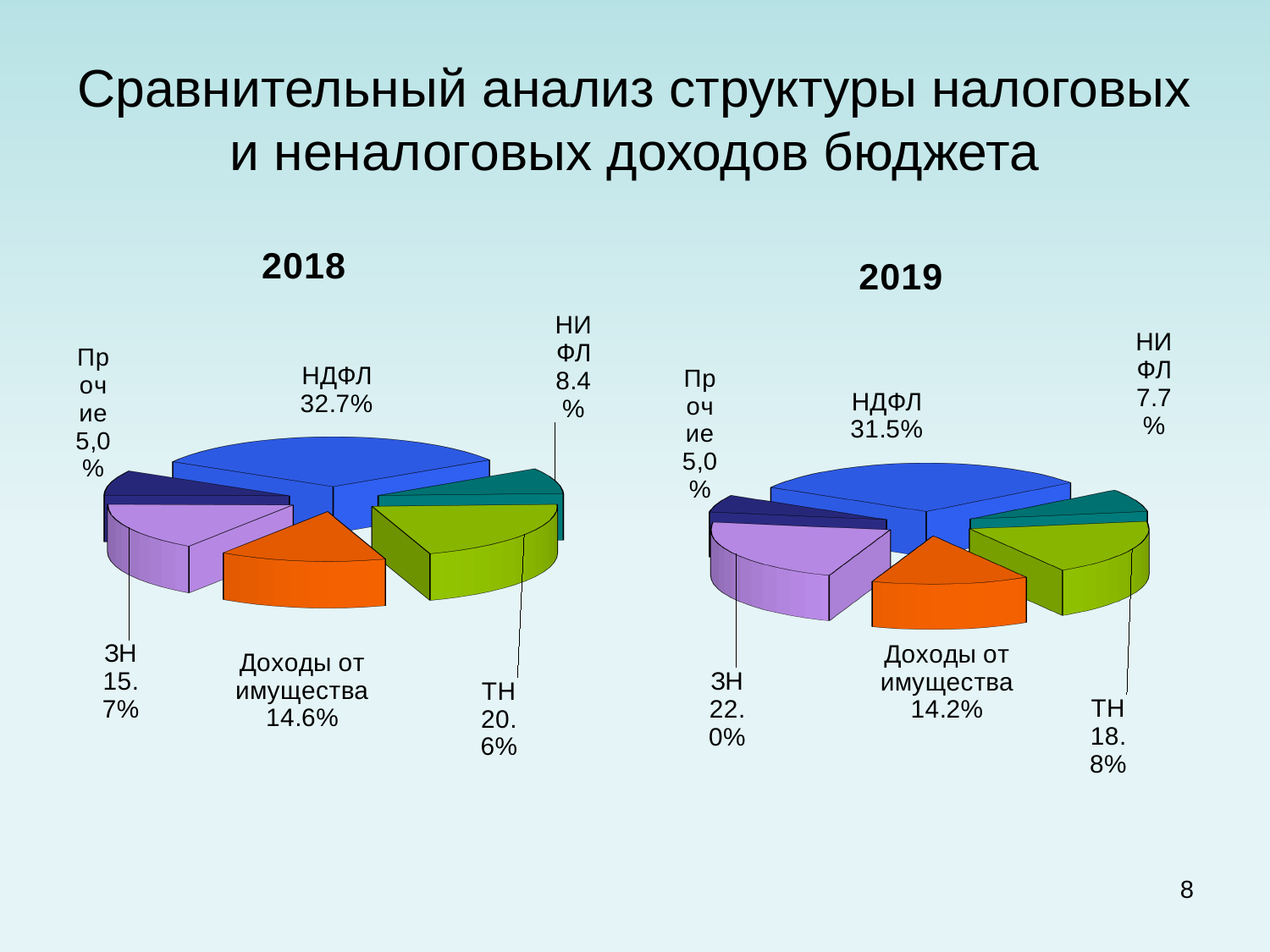
In the 2019 chart, which category has the smallest share? Прочие What is the difference between the ЗН share in 2019 and in 2018? 6.3% In the 2019 chart, what is the value for ЗН? 22.0% In the 2018 chart, which is larger: ТН or ЗН? ТН In the 2018 chart, what share does НДФЛ have? 32.7% In the 2018 chart, which category has the largest share? НДФЛ What kind of chart is used for the 2018 data? Pie chart In the 2018 chart, what is the value for НИФЛ? 8.4% How many categories are shown in the 2019 pie chart? 6 In the 2019 chart, which is larger: ЗН or ТН? ЗН In the 2019 chart, what share does ТН have? 18.8% In the 2018 chart, what is the value for Доходы от имущества? 14.6%